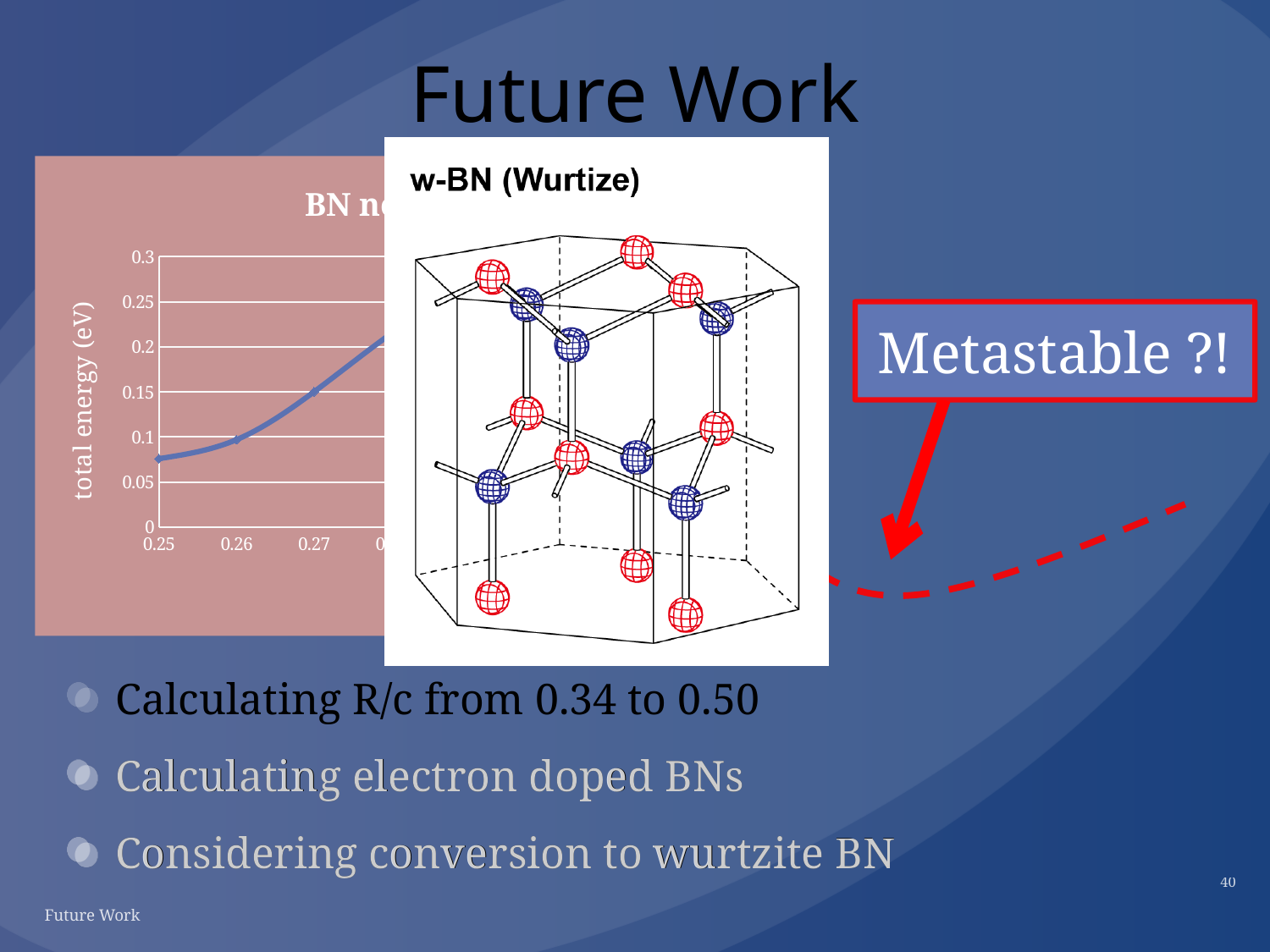
Which has the larger total energy, x = 0.25 or x = 0.27? 0.27 What is the label of the y axis of the chart? total energy (eV) Which has the smaller total energy, x = 0.26 or x = 0.27? 0.26 What is the highest value shown on the y axis of the chart? 0.3 What kind of chart is shown on the left of the slide? line chart Does the plotted line rise or fall as the x-axis value increases from 0.25 to 0.27? rise Is the total energy at x = 0.25 greater or less than 0.1? less Is the total energy at x = 0.25 greater or less than 0.05? greater Is the total energy at x = 0.27 greater or less than 0.1? greater